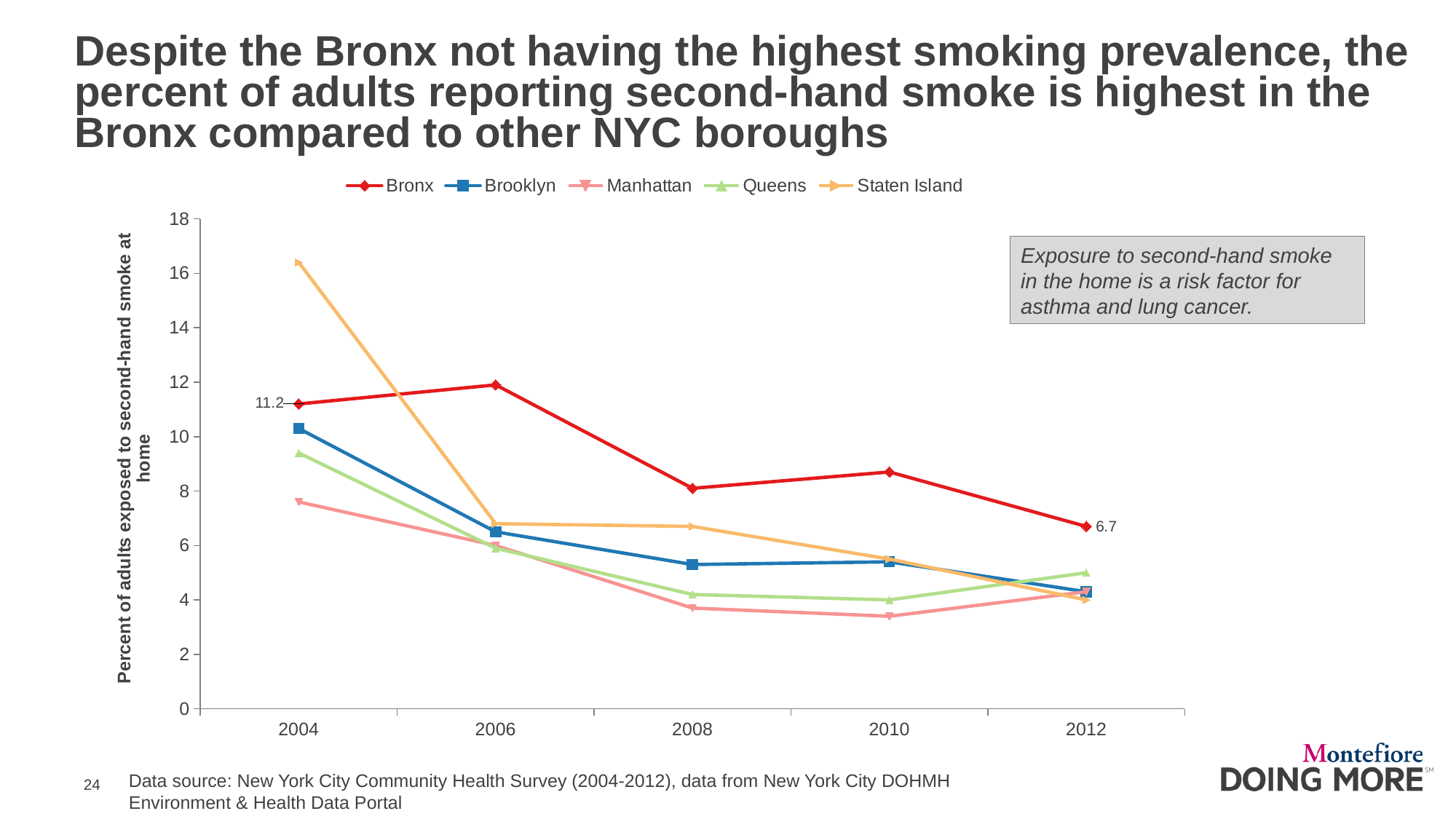
Does the Bronx line rise or fall overall from 2004 to 2012? Fall Which borough has the lowest value in 2010? Manhattan Which borough has the highest value in 2004? Staten Island Which borough has the highest value in 2012? Bronx What is the value for the Bronx in 2004? 11.2 By how much did the Bronx value fall from 2004 to 2012? 4.5 Is the value for Staten Island in 2004 greater or less than 14? greater What is the value for the Bronx in 2012? 6.7 How many series does the legend list? 5 What kind of chart is shown on the slide? Line chart How many years are shown on the x axis? 5 Which is larger in 2004, the value for Brooklyn or the value for Manhattan? Brooklyn